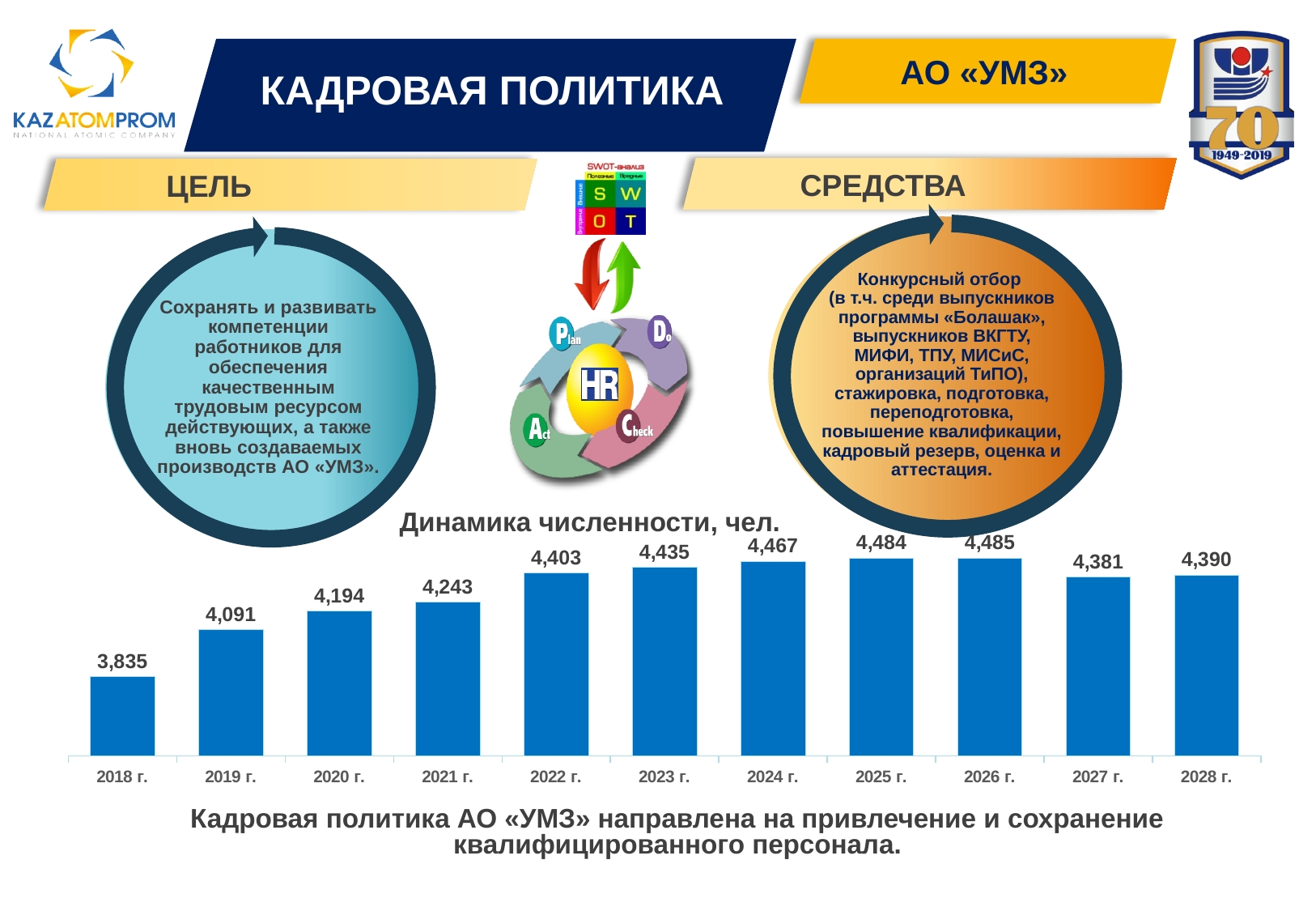
What is the value for 2023 г. in the chart 'Динамика численности, чел.'? 4,435 What is the value for 2028 г. in the chart 'Динамика численности, чел.'? 4,390 What is the value for 2018 г. in the chart 'Динамика численности, чел.'? 3,835 How many years are shown on the x axis of the chart 'Динамика численности, чел.'? 11 Do the values in the chart 'Динамика численности, чел.' rise or fall from 2018 г. to 2022 г.? Rise What is the title of the bar chart on the slide? Динамика численности, чел. What is the difference between the values for 2026 г. and 2027 г. in the chart 'Динамика численности, чел.'? 104 What is the difference between the values for 2028 г. and 2018 г. in the chart 'Динамика численности, чел.'? 555 What kind of chart is 'Динамика численности, чел.'? Bar chart Which is larger in the chart 'Динамика численности, чел.': the value for 2022 г. or the value for 2027 г.? 2022 г. Which year has the highest value in the chart 'Динамика численности, чел.'? 2026 г. Which year has the lowest value in the chart 'Динамика численности, чел.'? 2018 г.